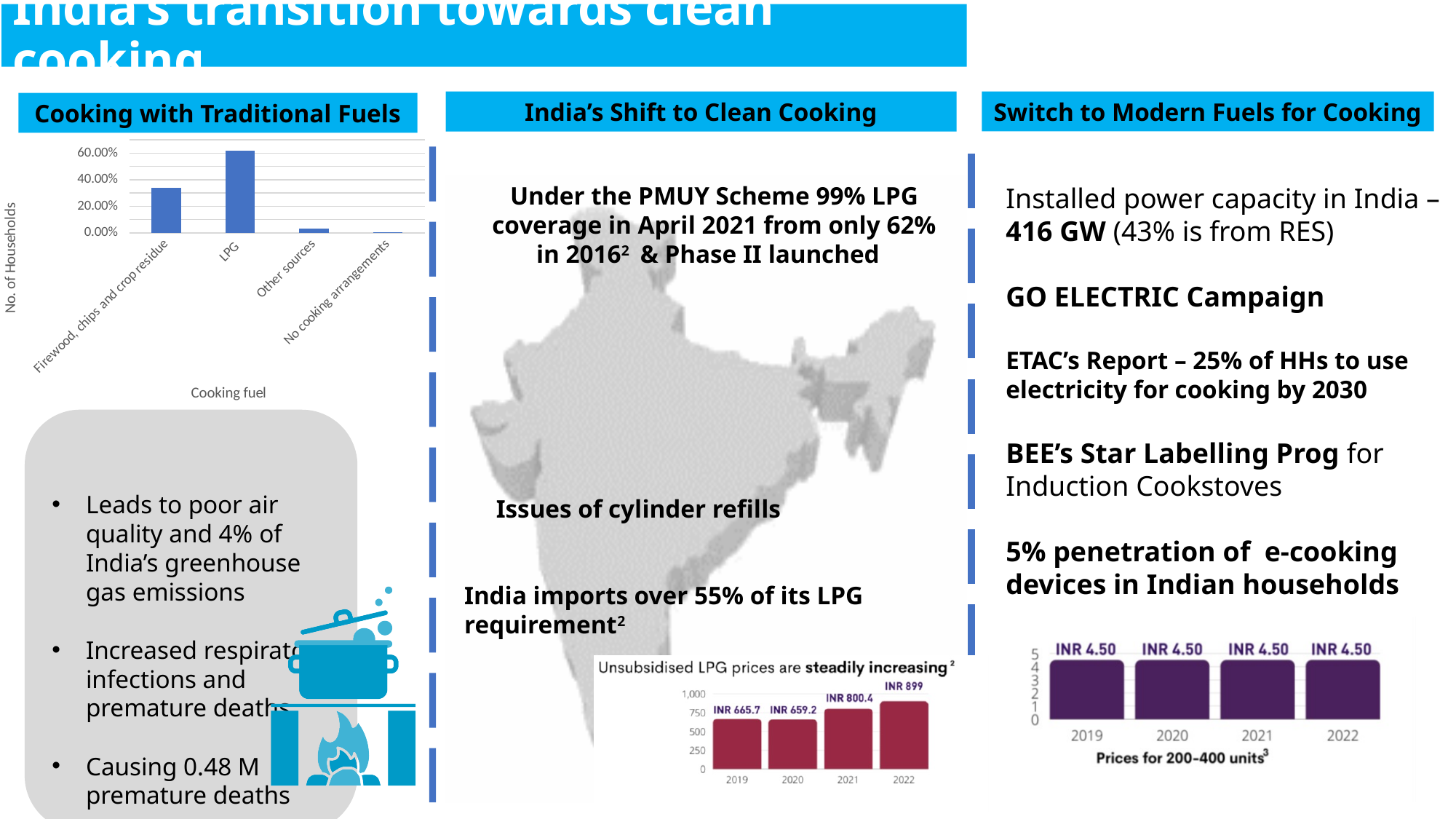
On the 'Cooking fuel' chart on the left, is the value for 'Firewood, chips and crop residue' greater or less than 20.00%? greater On the 'Unsubsidised LPG prices are steadily increasing' chart, what is the price for 2019? INR 665.7 On the 'Unsubsidised LPG prices are steadily increasing' chart, which year has the lowest price? 2020 On the 'Cooking fuel' chart on the left, how many cooking fuel categories are plotted? 4 On the 'Cooking fuel' chart on the left, which is larger: 'Firewood, chips and crop residue' or 'Other sources'? Firewood, chips and crop residue On the 'Unsubsidised LPG prices are steadily increasing' chart, what is the difference between the 2022 and 2021 prices? INR 98.6 On the 'Cooking fuel' chart on the left, what is the label of the vertical axis? No. of Households On the 'Cooking fuel' chart on the left, what kind of chart is shown? Bar chart On the 'Unsubsidised LPG prices are steadily increasing' chart, what is the price for 2022? INR 899 On the 'Prices for 200-400 units' chart on the right, do the prices rise, fall or stay the same from 2019 to 2022? Stay the same On the 'Cooking fuel' chart on the left, which category has the highest share of households? LPG On the 'Prices for 200-400 units' chart on the right, what is the price for 2021? INR 4.50